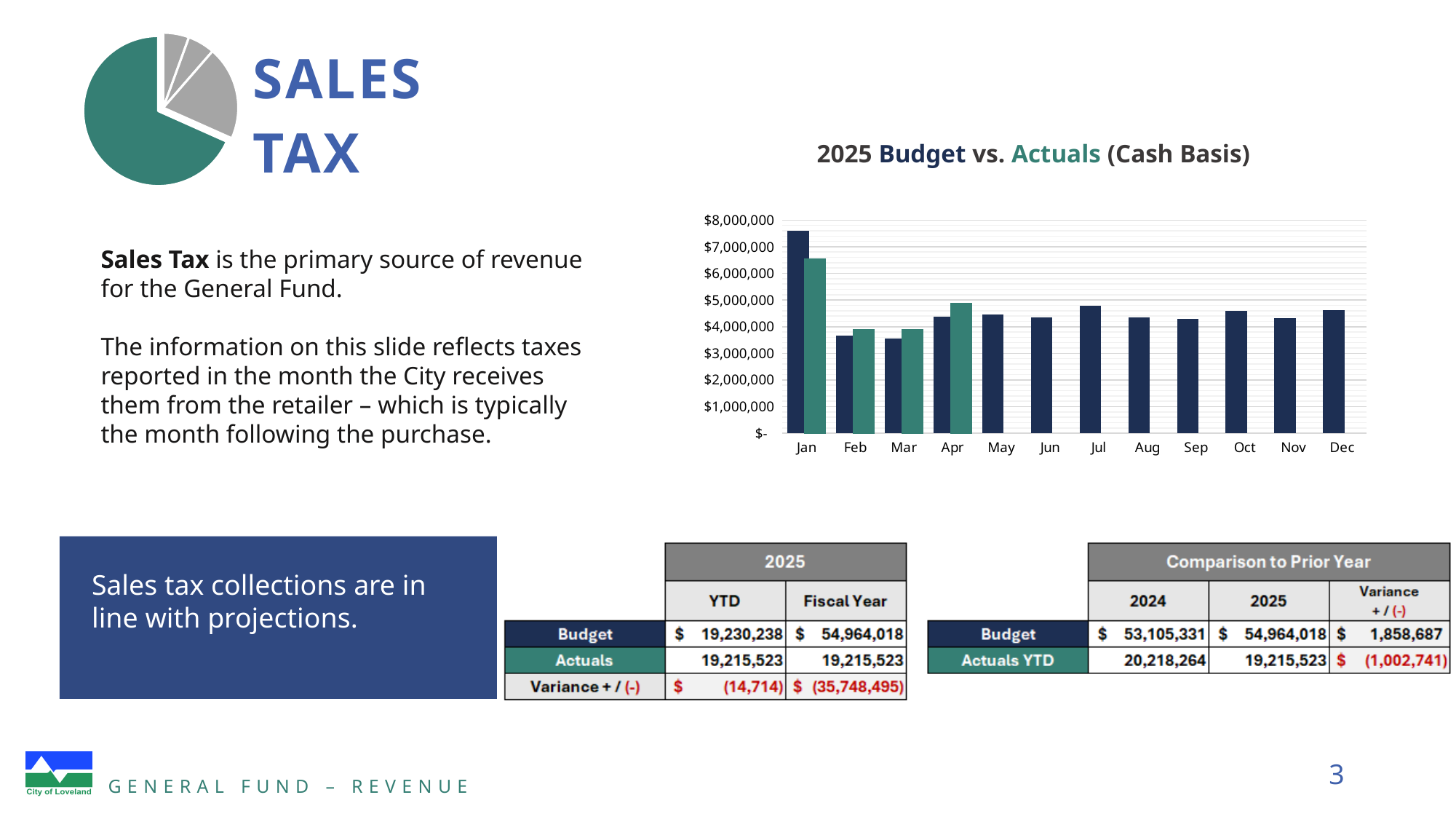
In the "2025 Budget vs. Actuals (Cash Basis)" chart, is the Jan actuals bar greater or less than $7,000,000? less How many months are shown on the x axis of the "2025 Budget vs. Actuals (Cash Basis)" chart? 12 In the "2025 Budget vs. Actuals (Cash Basis)" chart, what colour are the Actuals bars? green In the "2025 Budget vs. Actuals (Cash Basis)" chart, is the Jan budget bar greater or less than $7,000,000? greater In the "2025 Budget vs. Actuals (Cash Basis)" chart, is the Jul budget bar greater or less than $4,000,000? greater What kind of chart is the "2025 Budget vs. Actuals (Cash Basis)" chart? bar chart In the "2025 Budget vs. Actuals (Cash Basis)" chart, how many months have an Actuals (green) bar? 4 In the "2025 Budget vs. Actuals (Cash Basis)" chart, which is larger for Apr: the budget bar or the actuals bar? actuals In the "2025 Budget vs. Actuals (Cash Basis)" chart, which month has the tallest bar? Jan In the "2025 Budget vs. Actuals (Cash Basis)" chart, which is larger for Jan: the budget bar or the actuals bar? budget